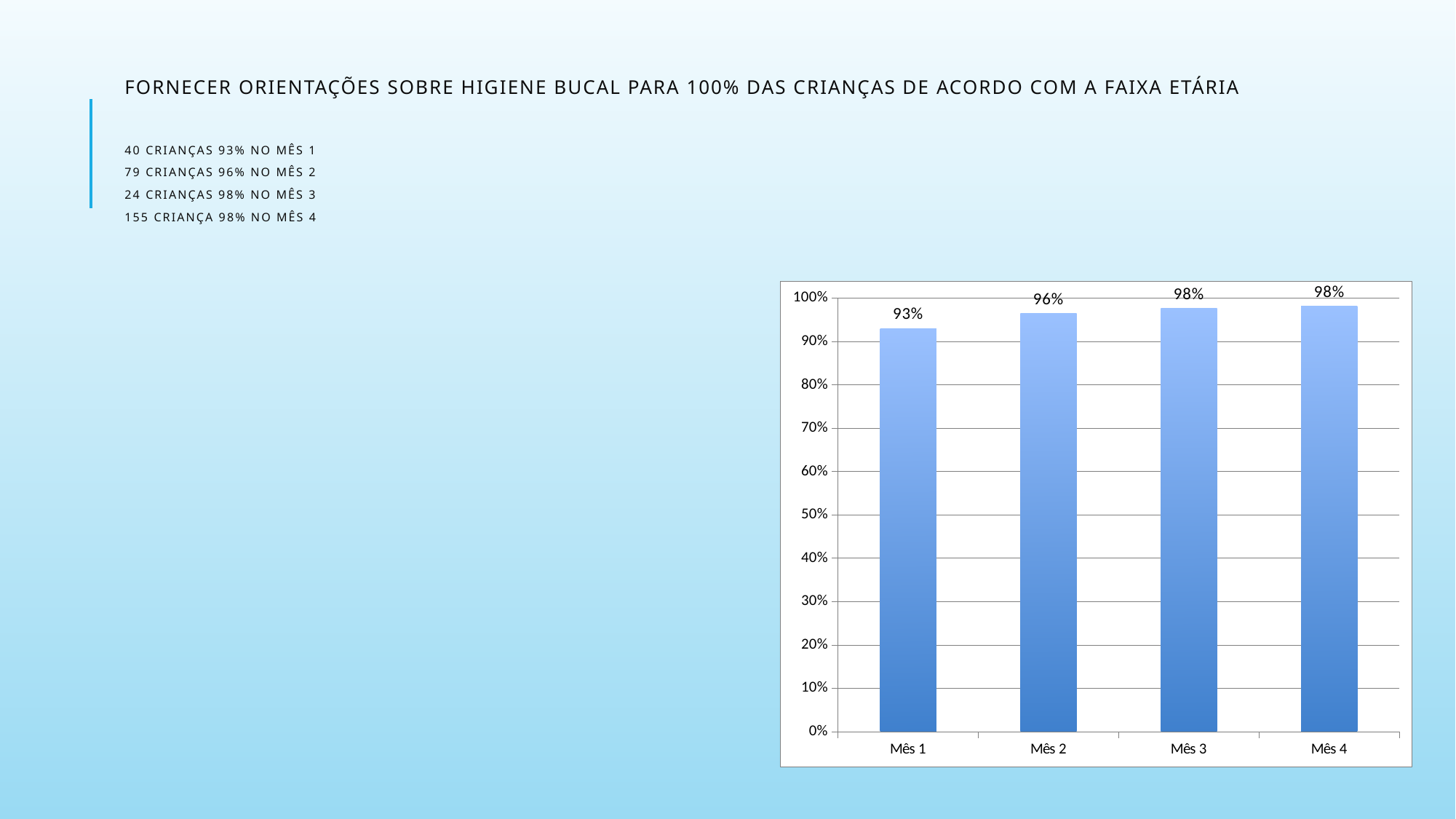
What is the value for Mês 1? 93% How many categories are shown on the x axis? 4 What is the value for Mês 4? 98% What kind of chart is shown on the slide? bar chart What is the difference between the values for Mês 3 and Mês 1? 5% What is the difference between the values for Mês 2 and Mês 1? 3% Is the value for Mês 1 greater or less than 90%? greater Which is larger, the value for Mês 2 or the value for Mês 1? Mês 2 Do the values rise or fall from Mês 1 to Mês 3? rise What is the value for Mês 3? 98% Which month has the lowest value? Mês 1 What is the value for Mês 2? 96%